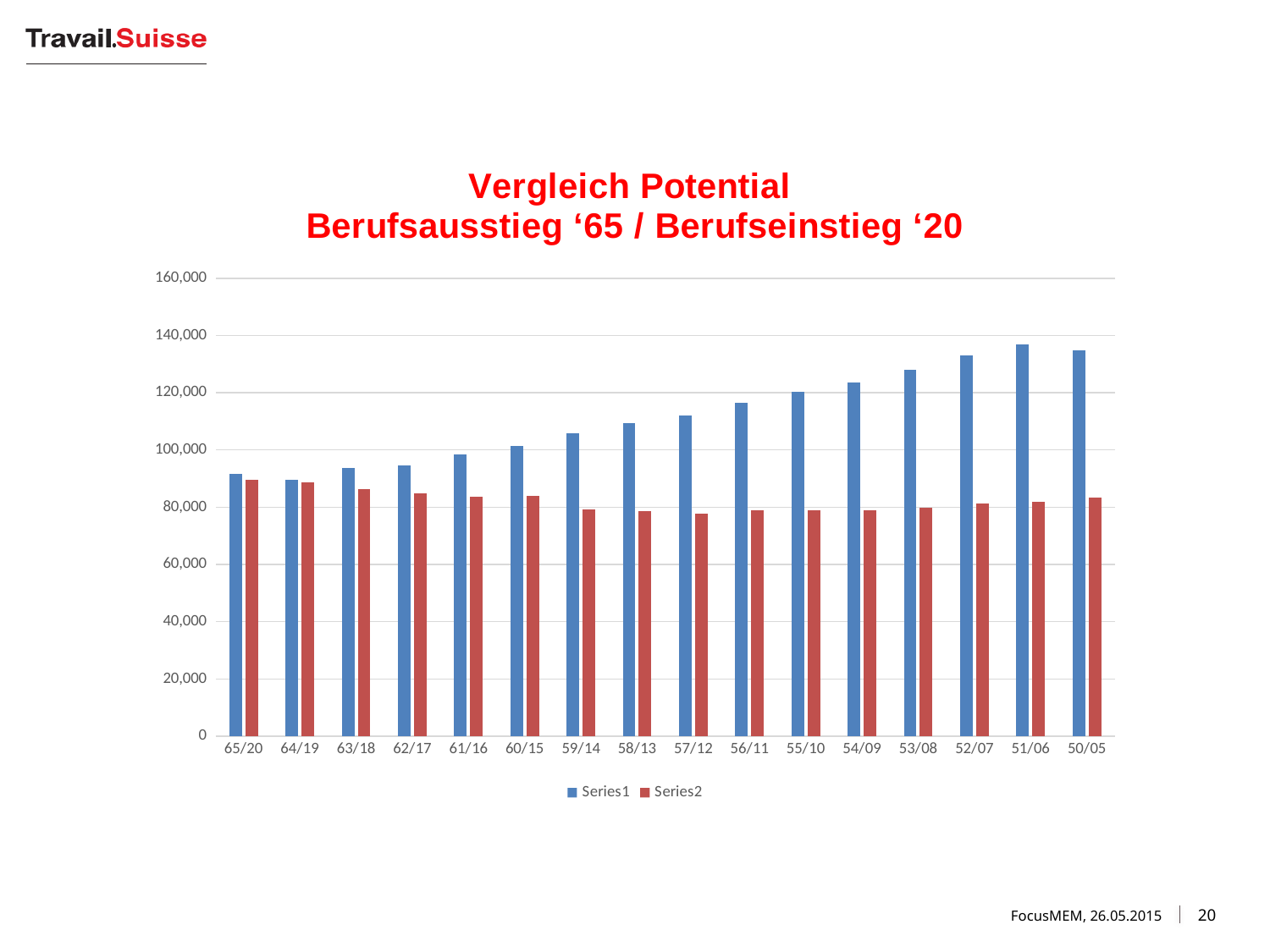
Is the Series1 value for 65/20 greater or less than 100,000? less For the category 50/05, which series has the larger value, Series1 or Series2? Series1 Do the Series1 values rise or fall moving from 65/20 to 50/05 along the x axis? rise Which category has the highest value for Series2? 65/20 How many series does the legend list? 2 Is the Series1 value for 53/08 greater or less than 120,000? greater Which category has the highest value for Series1? 51/06 How many categories are shown on the x axis? 16 What is the title of the chart? Vergleich Potential Berufsausstieg '65 / Berufseinstieg '20 Which colour represents Series2 in the chart? red What kind of chart is shown on the slide? bar chart